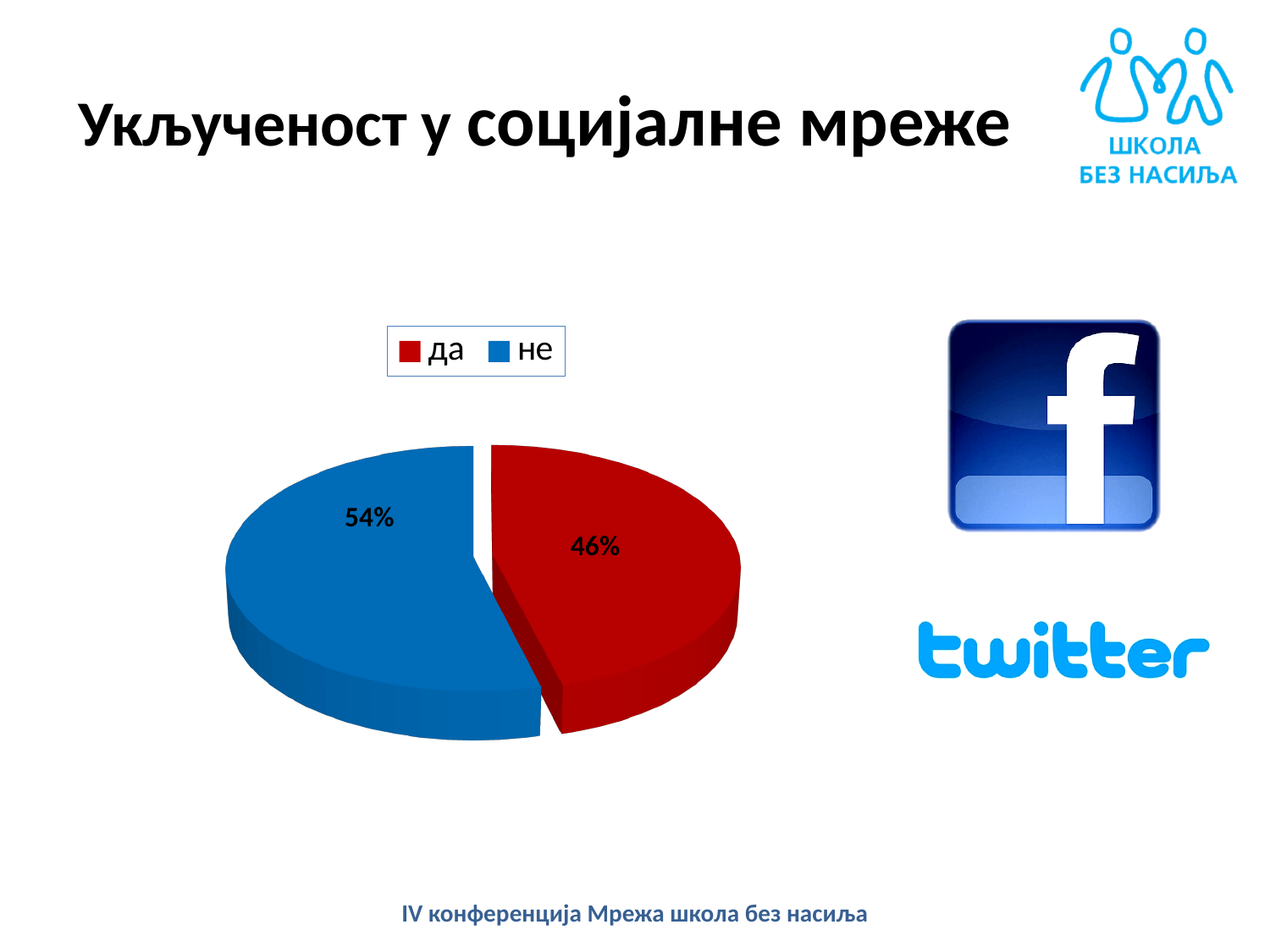
What colour is the "да" slice in the pie chart? red Is the share of the "да" slice greater or less than 50%? less Which slice is the largest in the pie chart? не What colour is the "не" slice in the pie chart? blue How many slices does the pie chart have? 2 How many entries does the legend list? 2 What share of the pie does the "не" slice represent? 54% Which slice is the smallest in the pie chart? да What is the difference in percentage points between the "не" and "да" slices? 8% What kind of chart is shown on the slide? pie chart What share of the pie does the "да" slice represent? 46% Which is larger, the "да" slice or the "не" slice? не